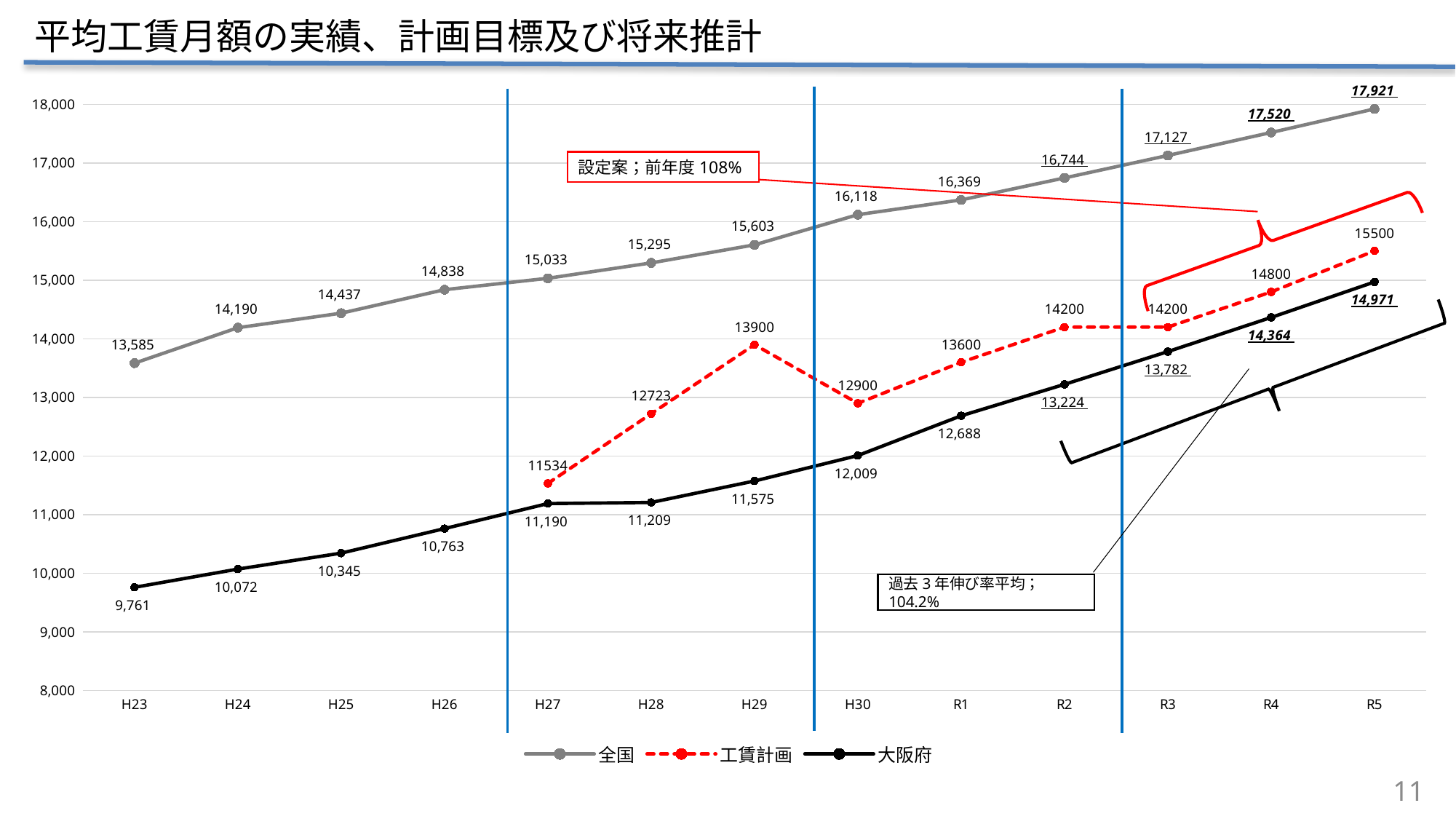
Does the 大阪府 series rise or fall from H23 to R5? rise Which is larger at H30: the 工賃計画 value or the 大阪府 value? 工賃計画 What is the value for 全国 at H23? 13,585 At which x-axis category is the 大阪府 series lowest? H23 At which x-axis category is the 全国 series highest? R5 How many series does the legend list? 3 What is the title of the chart on the slide? 平均工賃月額の実績、計画目標及び将来推計 What is the value for 工賃計画 at H29? 13900 What is the difference between the 全国 value and the 大阪府 value at R5? 2,950 What kind of chart is shown on the slide? line chart What is the value for 大阪府 at R5? 14,971 How many categories are shown on the x axis? 13